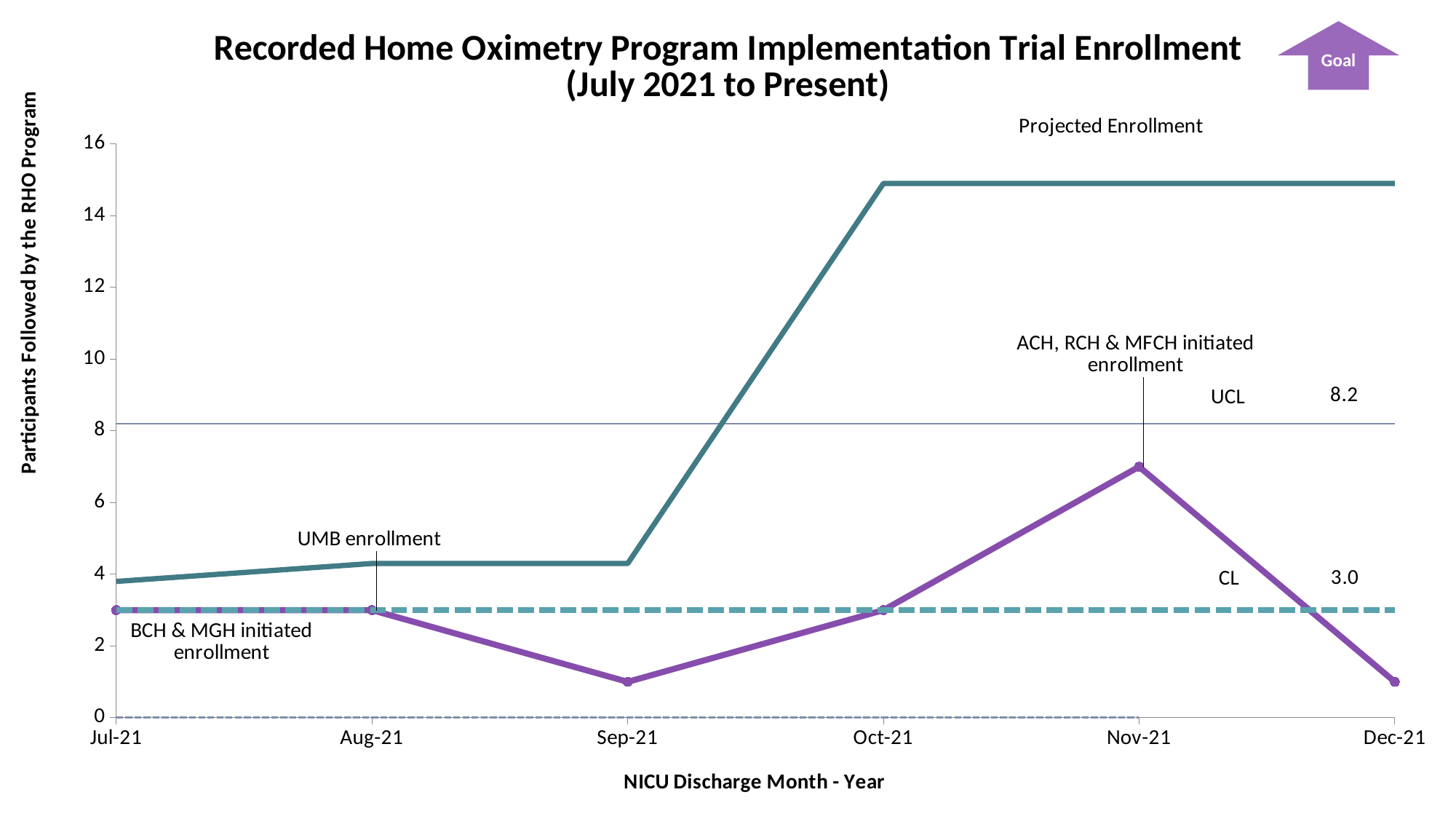
Is the value of the purple participants line for Nov-21 greater or less than 6? greater Is the value of the purple participants line for Sep-21 greater or less than 2? less What is the value of the CL shown on the chart? 3.0 Which month has the larger value on the purple participants line, Oct-21 or Nov-21? Nov-21 How many months are labelled along the x axis? 6 What annotation is attached to the Nov-21 point on the purple line? ACH, RCH & MFCH initiated enrollment What is the title of the chart? Recorded Home Oximetry Program Implementation Trial Enrollment (July 2021 to Present) In which month does the purple line of participants followed reach its highest value? Nov-21 Is the Projected Enrollment line at Dec-21 greater or less than 14? greater What is the value of the UCL shown on the chart? 8.2 Does the purple participants line rise or fall from Nov-21 to Dec-21? fall What kind of chart is shown on the slide? line chart